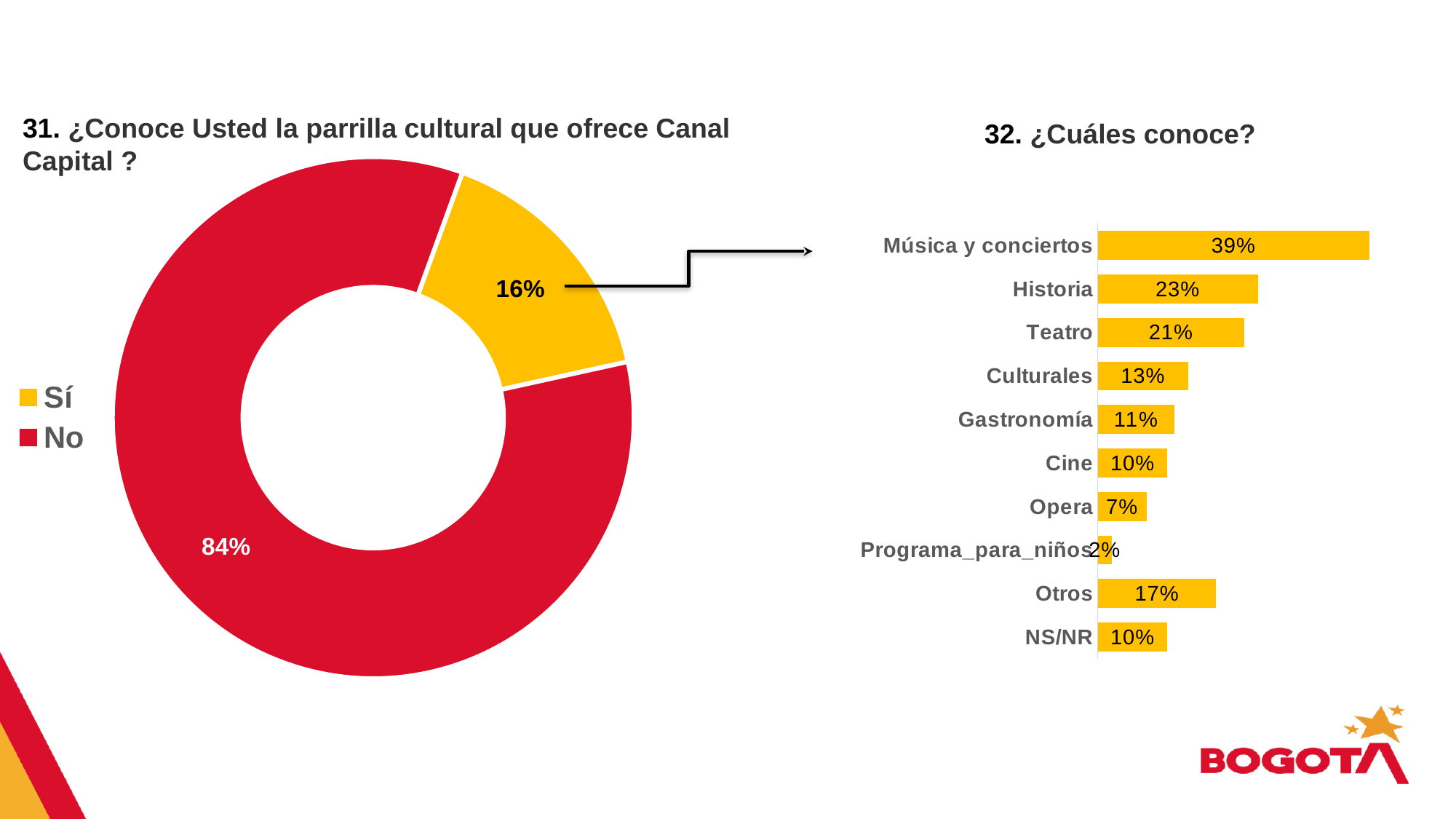
In the chart titled "32. ¿Cuáles conoce?", which category has the lowest value? Programa_para_niños In the chart titled "32. ¿Cuáles conoce?", what is the difference between the values for Historia and Teatro? 2% What kind of chart is the one on the right of the slide, titled "32. ¿Cuáles conoce?"? Bar chart In the chart titled "32. ¿Cuáles conoce?", how many categories are shown? 10 In the chart titled "32. ¿Cuáles conoce?", what is the value for Música y conciertos? 39% In the chart titled "32. ¿Cuáles conoce?", what is the value for Gastronomía? 11% In the chart titled "31. ¿Conoce Usted la parrilla cultural que ofrece Canal Capital ?", what share of respondents answered No? 84% What kind of chart is the one on the left of the slide, titled "31. ¿Conoce Usted la parrilla cultural que ofrece Canal Capital ?"? Doughnut (pie) chart In the chart titled "31. ¿Conoce Usted la parrilla cultural que ofrece Canal Capital ?", what share of respondents answered Sí? 16% In the chart titled "31. ¿Conoce Usted la parrilla cultural que ofrece Canal Capital ?", how many entries does the legend list? 2 In the chart titled "32. ¿Cuáles conoce?", which is larger, the value for Otros or the value for Culturales? Otros In the chart titled "32. ¿Cuáles conoce?", which category has the highest value? Música y conciertos